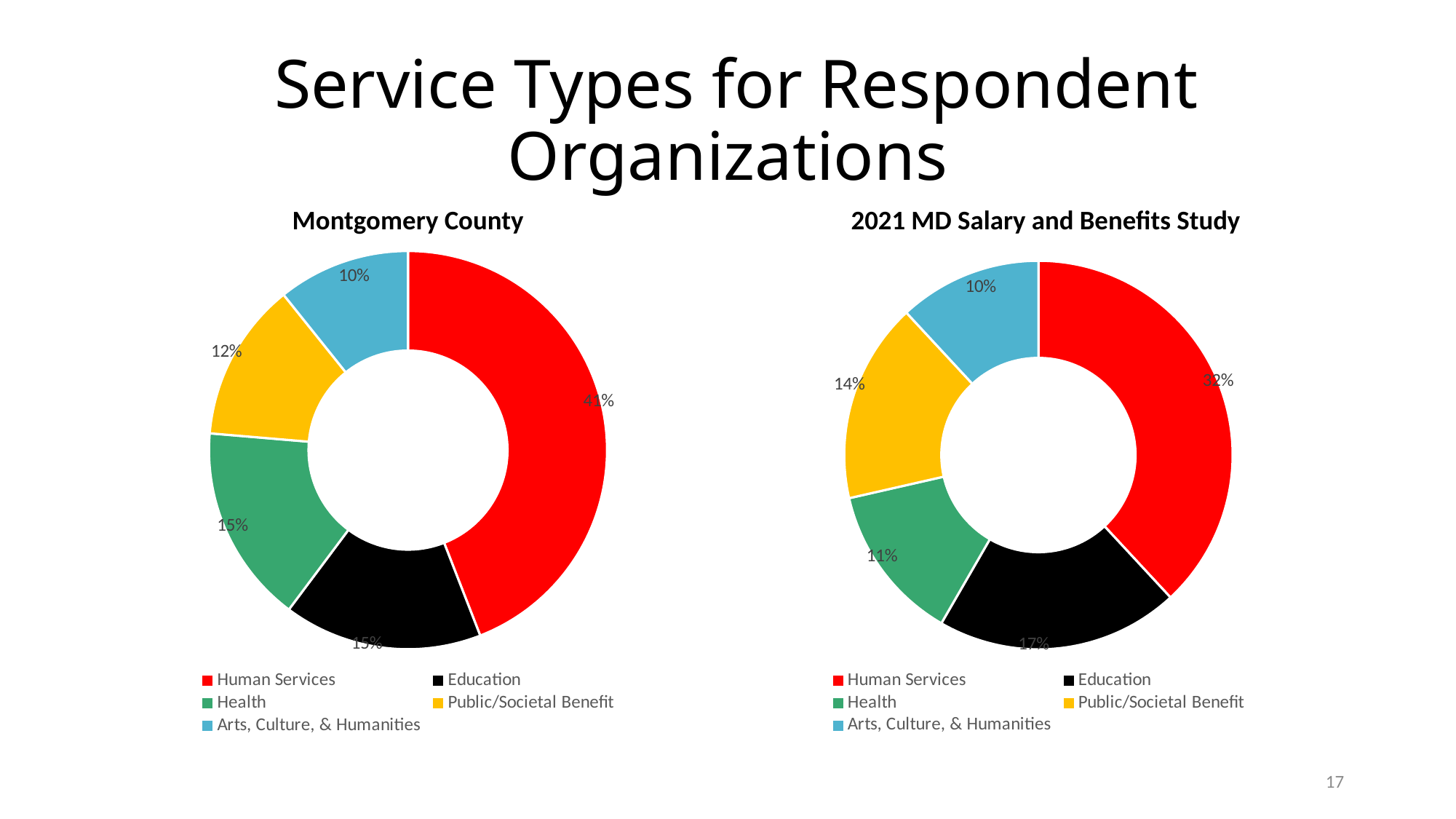
In the Montgomery County chart, what is the combined share of Education and Health? 30% What kind of chart is the 2021 MD Salary and Benefits Study chart? Donut (pie) chart In the 2021 MD Salary and Benefits Study chart, what share is Education? 17% In the Montgomery County chart, what share is Human Services? 41% How many categories does the Montgomery County chart show? 5 In the Montgomery County chart, which category has the largest share? Human Services In the 2021 MD Salary and Benefits Study chart, which is larger: Health or Public/Societal Benefit? Public/Societal Benefit What is the difference between the Human Services share in the Montgomery County chart and in the 2021 MD Salary and Benefits Study chart? 9 percentage points In the 2021 MD Salary and Benefits Study chart, which colour represents Health? Green In the Montgomery County chart, what share is Arts, Culture, & Humanities? 10% In the 2021 MD Salary and Benefits Study chart, which category has the smallest share? Arts, Culture, & Humanities In the 2021 MD Salary and Benefits Study chart, what share is Public/Societal Benefit? 14%